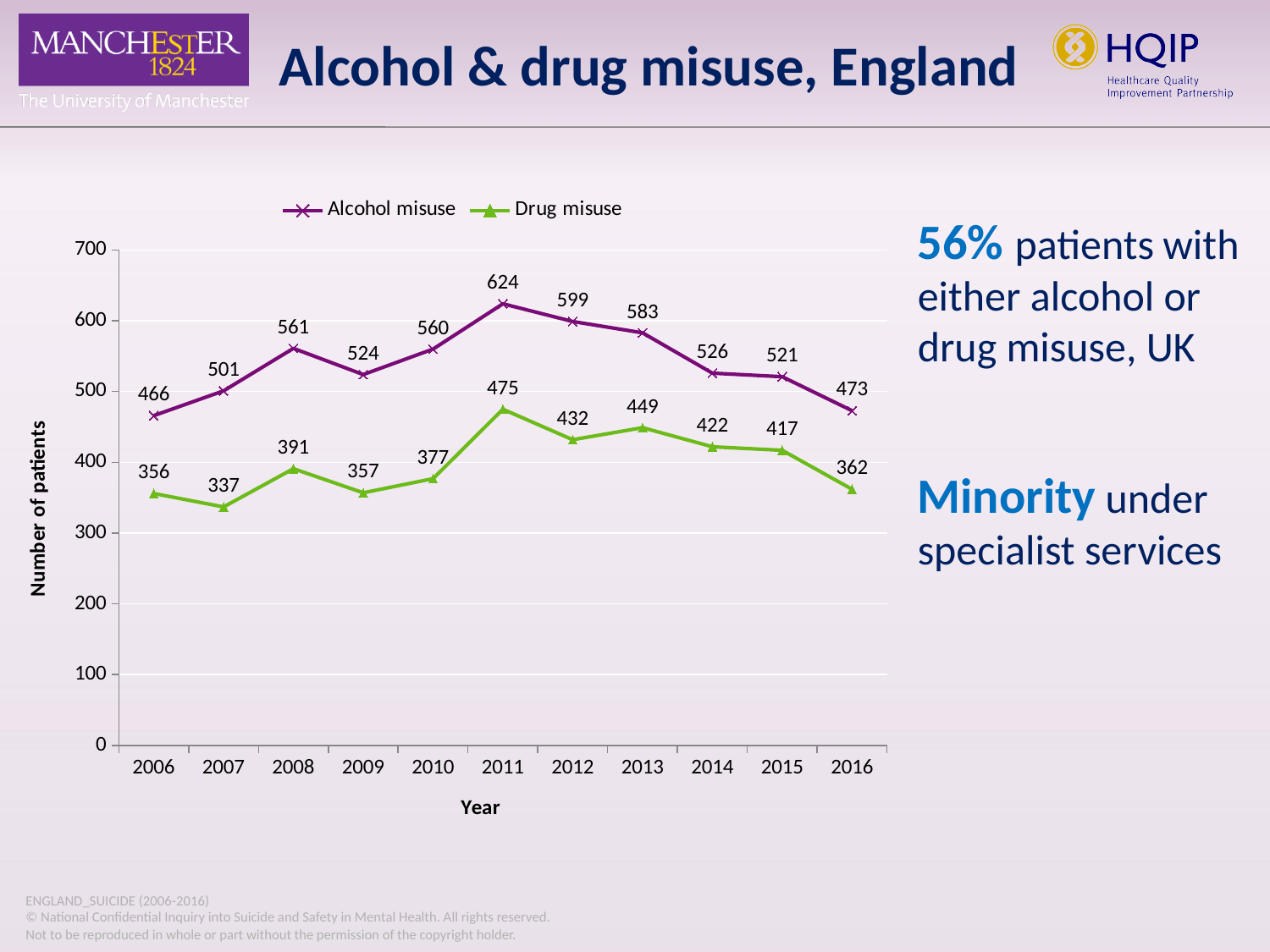
Is the value for Alcohol misuse in 2008 greater or less than 500? greater Which is larger, Drug misuse in 2013 or Drug misuse in 2012? Drug misuse in 2013 In which year is the Drug misuse series lowest? 2007 Does the Alcohol misuse series rise or fall from 2013 to 2016? Fall How many series does the legend list? 2 How many years are shown on the x axis? 11 What is the value for Alcohol misuse in 2011? 624 What is the value for Drug misuse in 2007? 337 In which year is the Alcohol misuse series highest? 2011 What kind of chart is shown on the slide? Line chart What is the label of the y axis? Number of patients What is the difference between Alcohol misuse and Drug misuse in 2016? 111